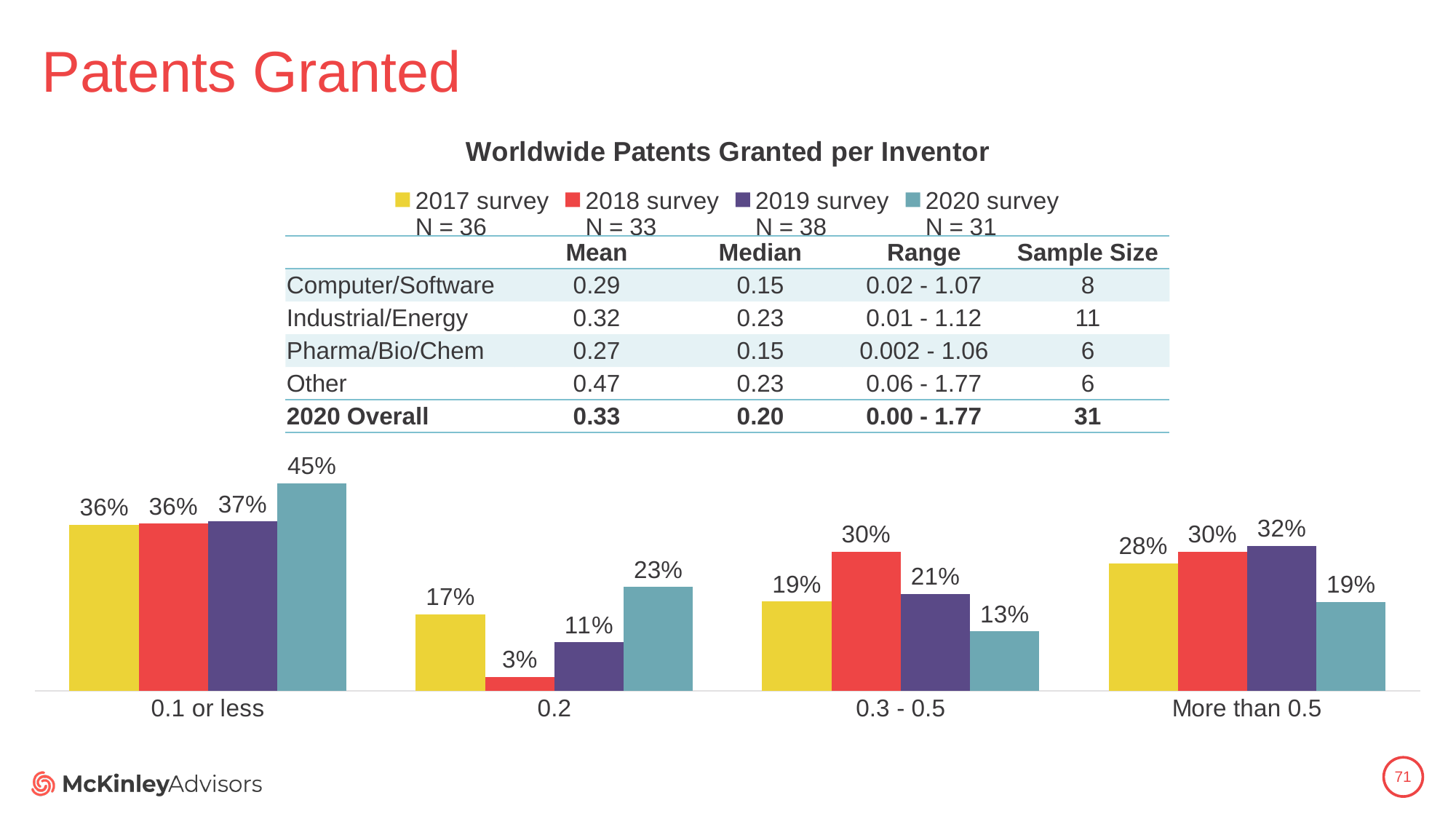
In the '0.3 - 0.5' category, which is larger: the 2018 survey value or the 2020 survey value? 2018 survey What is the title of the chart? Worldwide Patents Granted per Inventor What is the value for the 2020 survey in the '0.1 or less' category? 45% What is the value for the 2017 survey in the '0.3 - 0.5' category? 19% What is the value for the 2019 survey in the 'More than 0.5' category? 32% Which category has the lowest value for the 2018 survey? 0.2 Which category has the highest value for the 2020 survey? 0.1 or less How many series does the chart legend list? 4 How many categories are shown on the x axis of the chart? 4 What is the value for the 2018 survey in the '0.2' category? 3% What kind of chart is shown on the slide? Bar chart What is the difference between the 2020 survey and 2017 survey values in the '0.1 or less' category? 9%